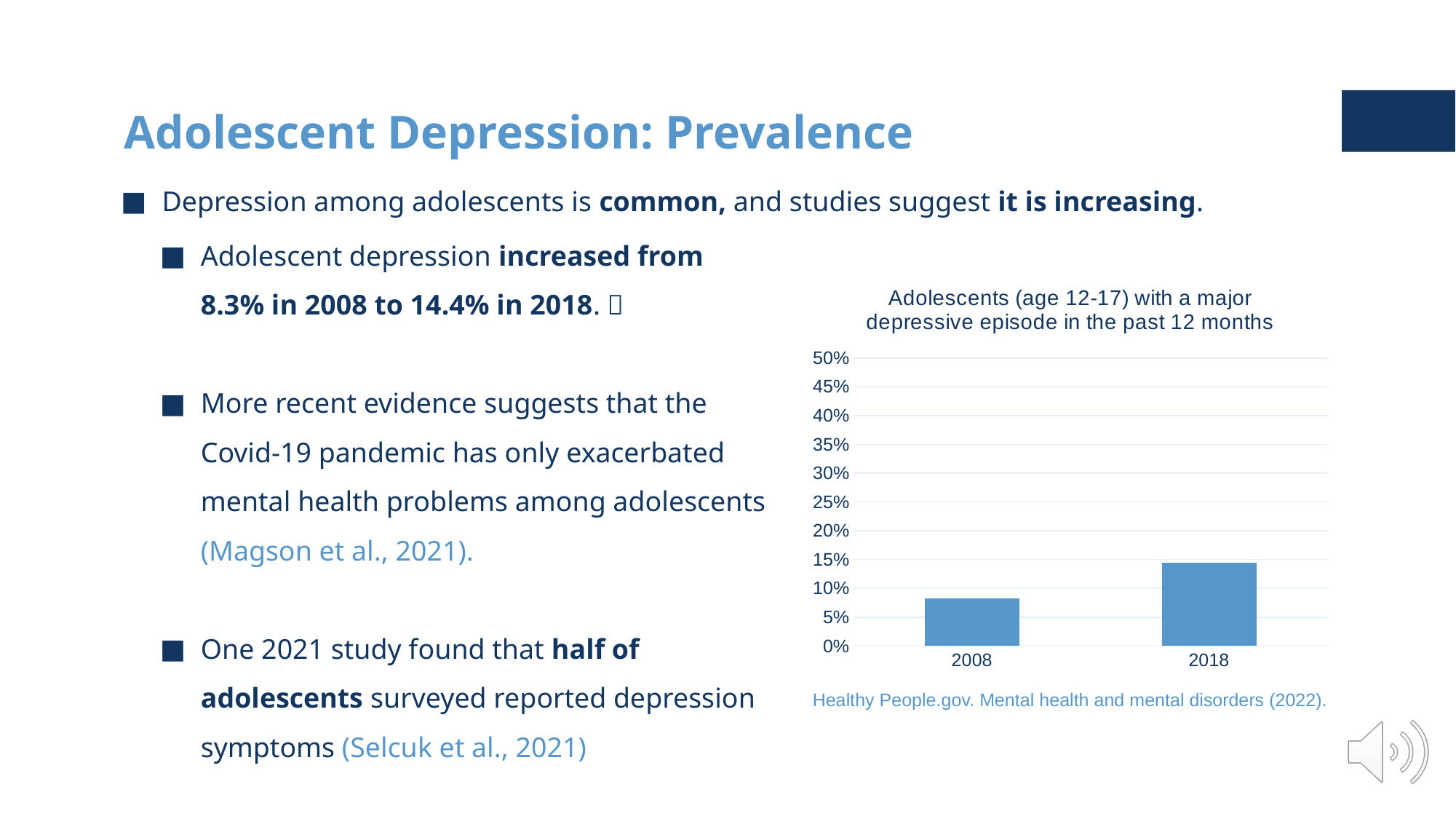
Is the value for 2018 greater or less than 20%? less Do the values rise or fall from 2008 to 2018? rise Is the value for 2008 greater or less than 5%? greater Is the bar for 2018 larger or smaller than the bar for 2008? larger Is the value for 2008 greater or less than 10%? less Which year has the higher value in the chart? 2018 How many bars (categories) does the chart show? 2 Which year has the lower value in the chart? 2008 What is the highest value shown on the chart's vertical axis? 50% What kind of chart is shown on the slide? bar chart What is the title of the chart? Adolescents (age 12-17) with a major depressive episode in the past 12 months